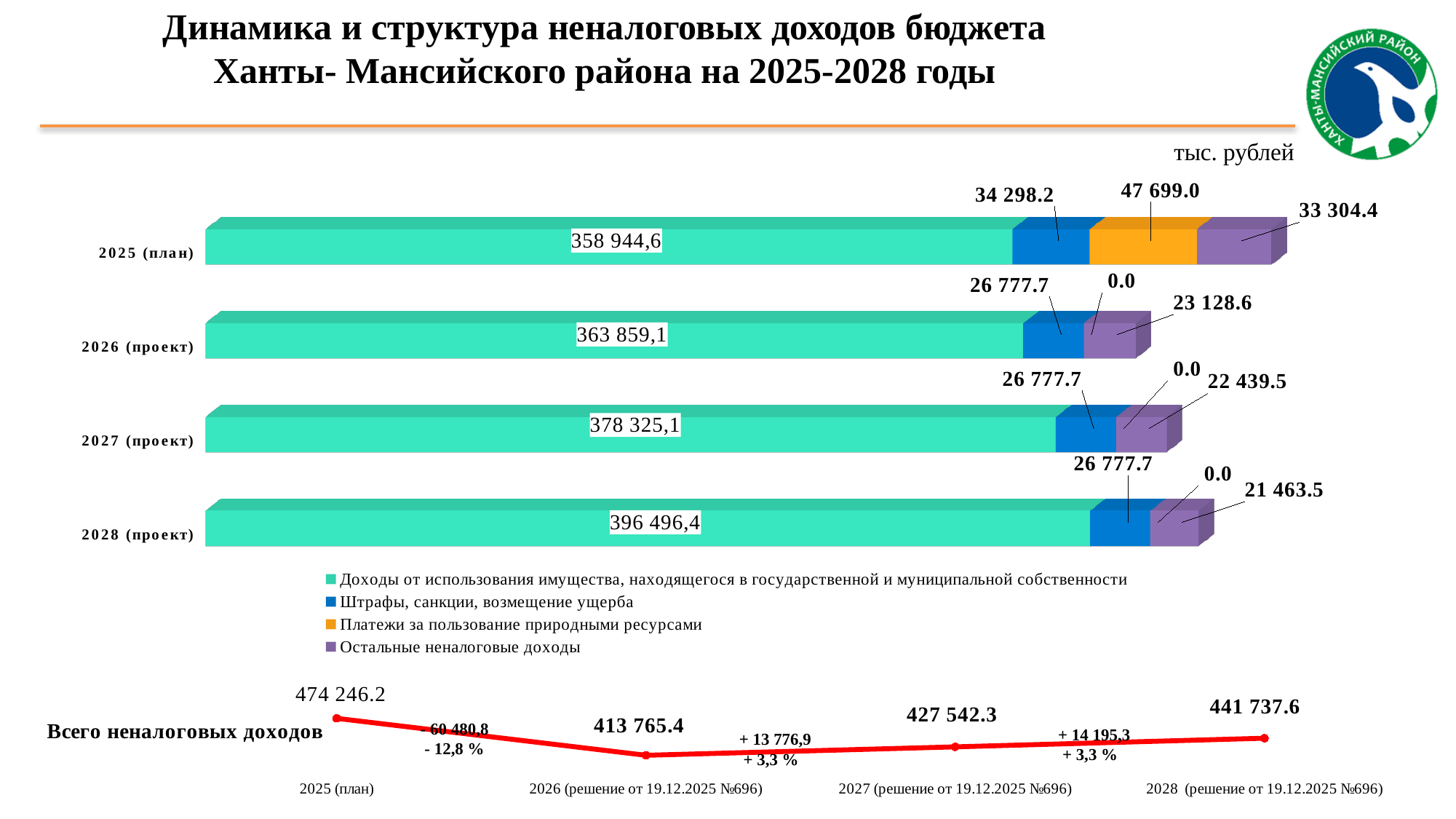
In the top stacked bar chart, which year has the highest value for 'Доходы от использования имущества, находящегося в государственной и муниципальной собственности'? 2028 (проект) In the top stacked bar chart, how many series does the legend list? 4 In the top stacked bar chart, which year has the lowest value for 'Остальные неналоговые доходы'? 2028 (проект) What kind of chart is the top chart on the slide? Stacked bar chart In the bottom line chart 'Всего неналоговых доходов', what is the difference between the 2028 value and the 2027 value? 14 195.3 In the top stacked bar chart, what is the value of 'Остальные неналоговые доходы' for 2028 (проект)? 21 463.5 In the bottom line chart 'Всего неналоговых доходов', what is the value for 2026? 413 765.4 In the top stacked bar chart, what is the value of 'Штрафы, санкции, возмещение ущерба' for 2026 (проект)? 26 777.7 In the top stacked bar chart, what is the value of 'Доходы от использования имущества, находящегося в государственной и муниципальной собственности' for 2025 (план)? 358 944,6 In the top stacked bar chart, how many year categories are shown? 4 In the bottom line chart 'Всего неналоговых доходов', which year has the highest value? 2025 (план) In the top stacked bar chart, what is the value of 'Платежи за пользование природными ресурсами' for 2025 (план)? 47 699.0